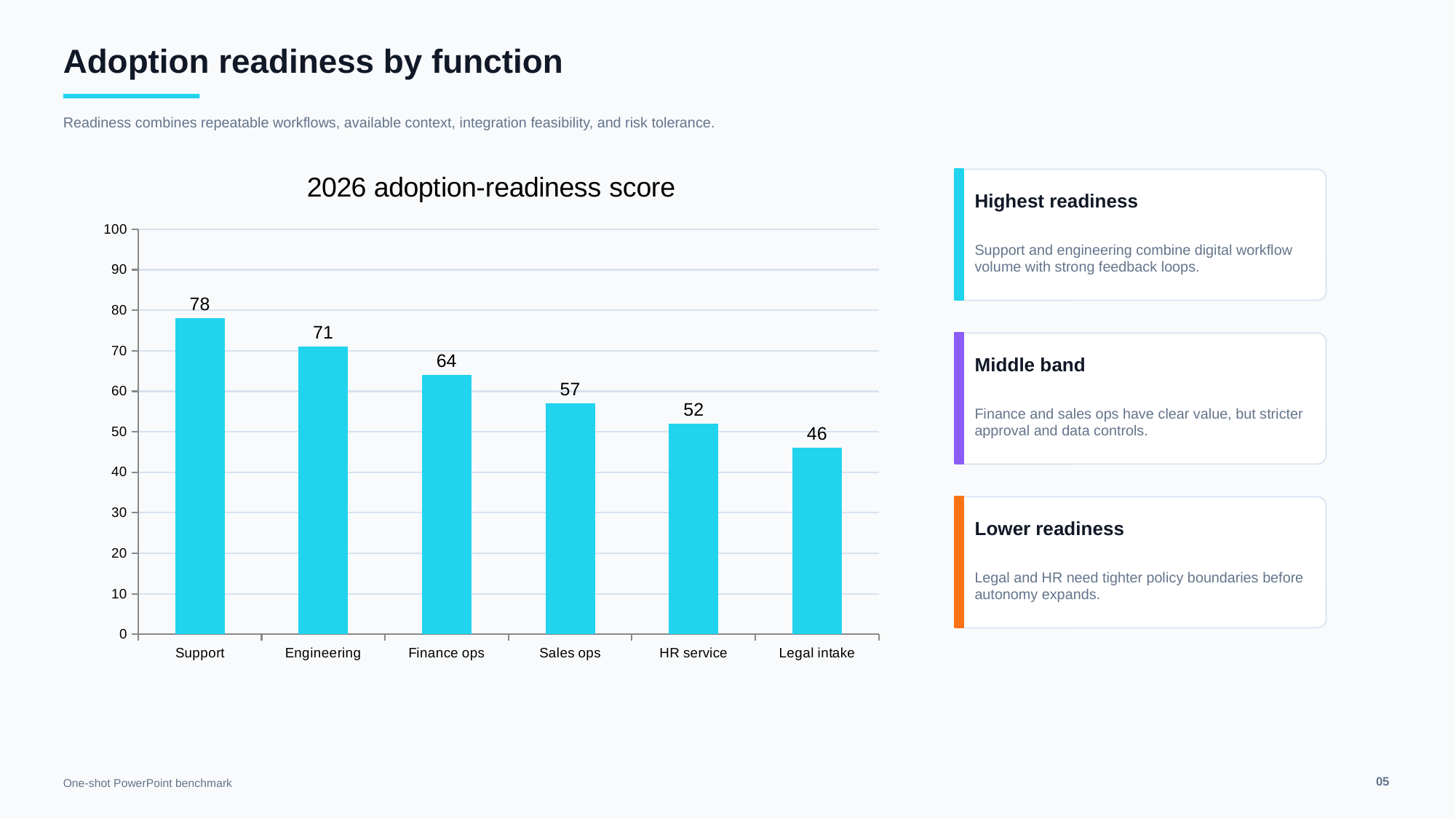
What is the adoption-readiness score for Support? 78 Is the value for Legal intake greater or less than 50? less What is the adoption-readiness score for Finance ops? 64 What is the difference between the scores for Engineering and HR service? 19 Which function has the lowest adoption-readiness score? Legal intake Which function has the highest adoption-readiness score? Support Do the scores rise or fall from left to right across the functions? Fall What is the adoption-readiness score for Legal intake? 46 What kind of chart is used to show the adoption-readiness scores? Bar chart How many functions are shown in the chart? 6 What is the title of the chart? 2026 adoption-readiness score Which has a higher adoption-readiness score, Sales ops or HR service? Sales ops